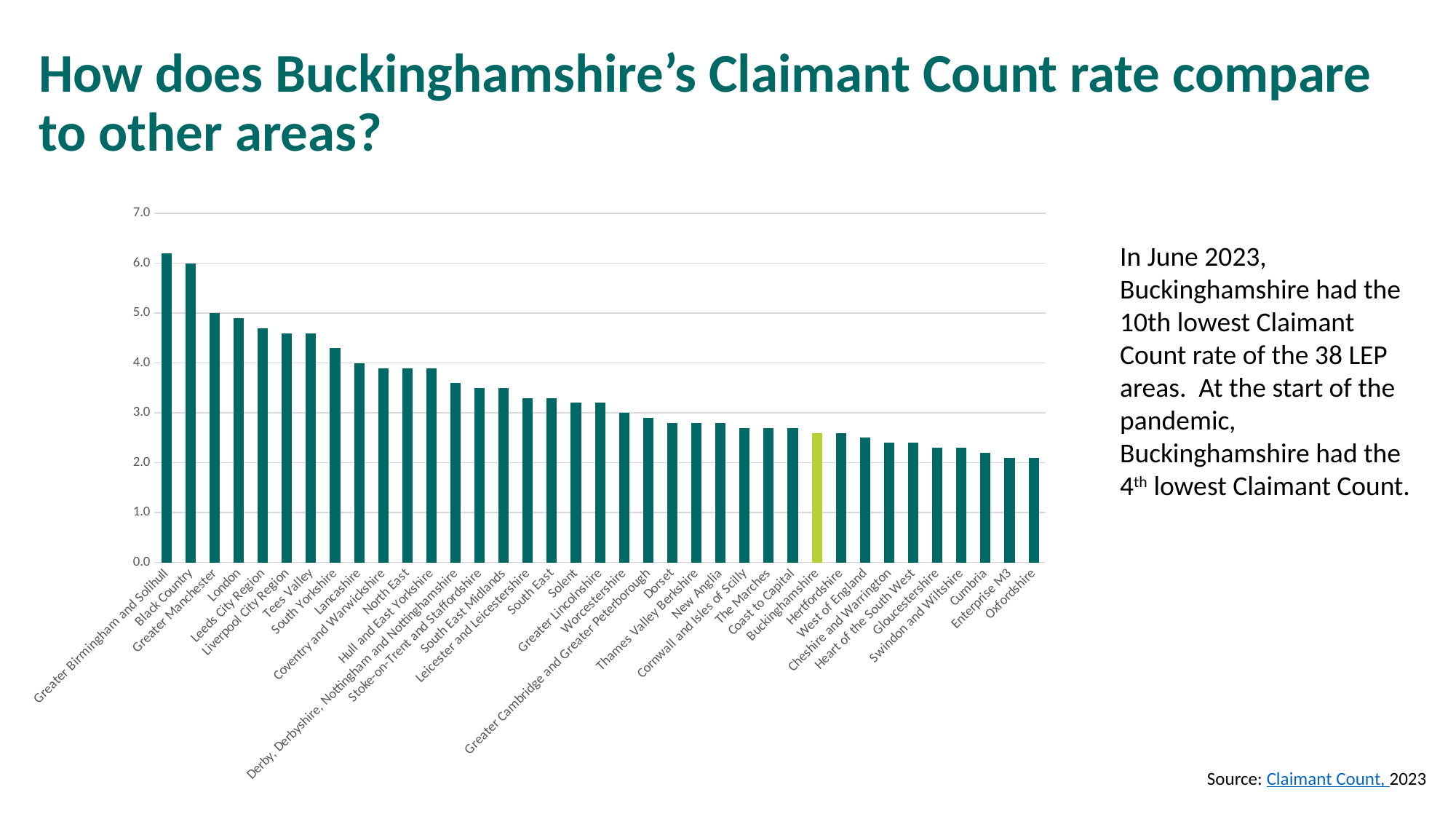
Which has the higher Claimant Count rate, London or Buckinghamshire? London What kind of chart is shown on the slide? Bar chart Is the value for Buckinghamshire greater or less than 3.0? less Which area's bar is highlighted in a different colour from the rest? Buckinghamshire Which has the higher Claimant Count rate, Black Country or Oxfordshire? Black Country Do the values rise or fall moving from left to right along the x axis? Fall Is the value for Oxfordshire greater or less than 3.0? less Is the value for Greater Birmingham and Solihull greater or less than 6.0? greater How many areas (bars) are shown in the chart? 37 Which area has the highest Claimant Count rate in the chart? Greater Birmingham and Solihull